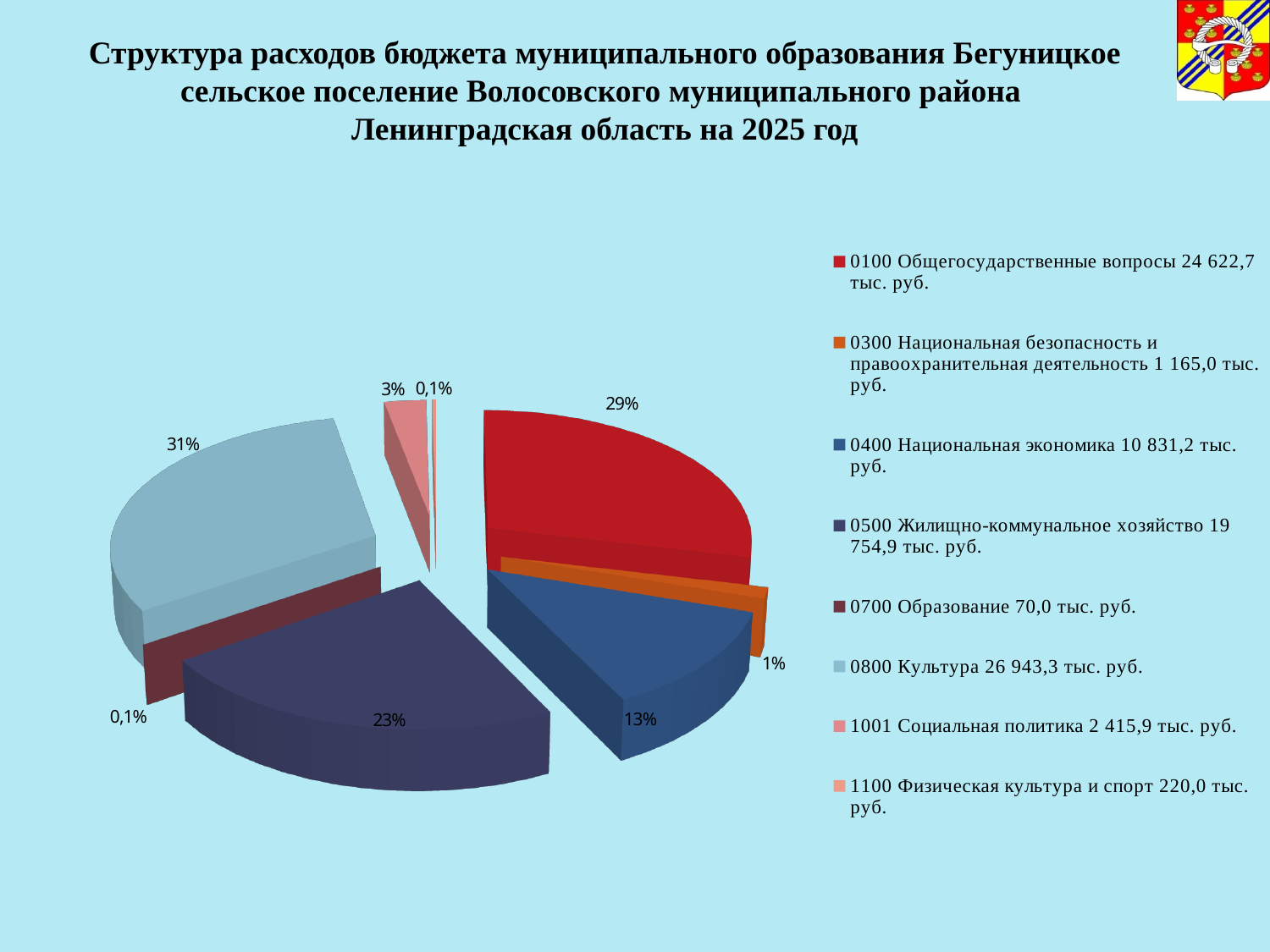
Which category has the smallest amount in the legend? 0700 Образование Which category has the largest slice of the pie? 0800 Культура What kind of chart is shown on the slide? pie chart How many categories does the pie chart have? 8 What share of the pie does 0100 Общегосударственные вопросы take? 29% What share of the pie does 0500 Жилищно-коммунальное хозяйство take? 23% What is the difference in percentage points between the 0800 Культура slice and the 0100 Общегосударственные вопросы slice? 2% What share of the pie does 0400 Национальная экономика take? 13% What is the amount shown in the legend for 0400 Национальная экономика? 10 831,2 тыс. руб. Which slice is larger: 0500 Жилищно-коммунальное хозяйство or 0400 Национальная экономика? 0500 Жилищно-коммунальное хозяйство What is the amount shown in the legend for 1001 Социальная политика? 2 415,9 тыс. руб.